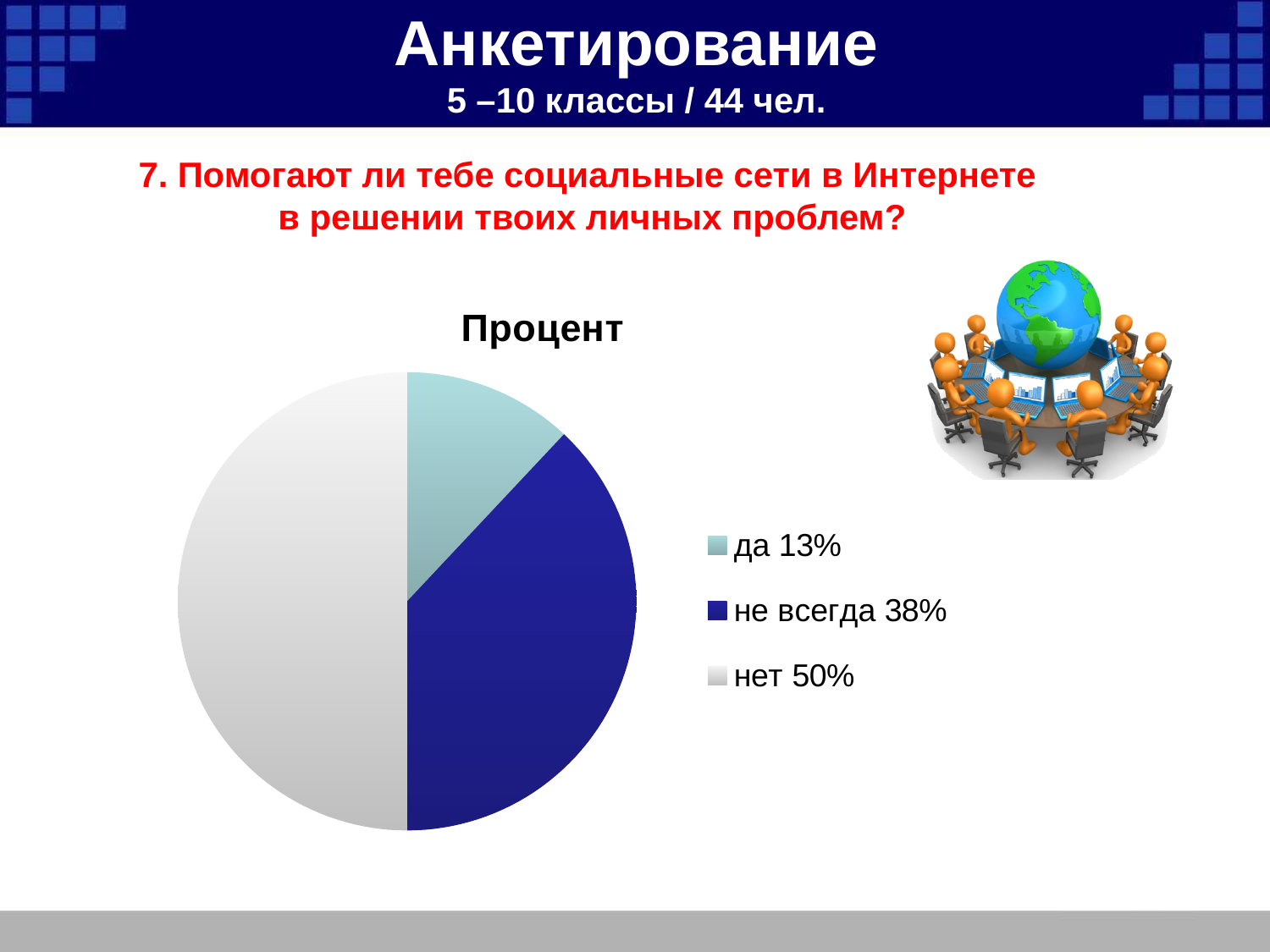
Which colour represents "нет" in the legend? light grey How many slices does the pie chart have? 3 What kind of chart is shown on the slide? pie chart What is the combined share of "да" and "не всегда"? 51% What percentage is shown for "не всегда"? 38% Which is larger, the share for "не всегда" or the share for "да"? не всегда What is the difference between the shares for "нет" and "не всегда"? 12% Which category has the largest share of the pie? нет What percentage is shown for "да"? 13% Which category has the smallest share of the pie? да What is the chart's title? Процент What percentage is shown for "нет"? 50%